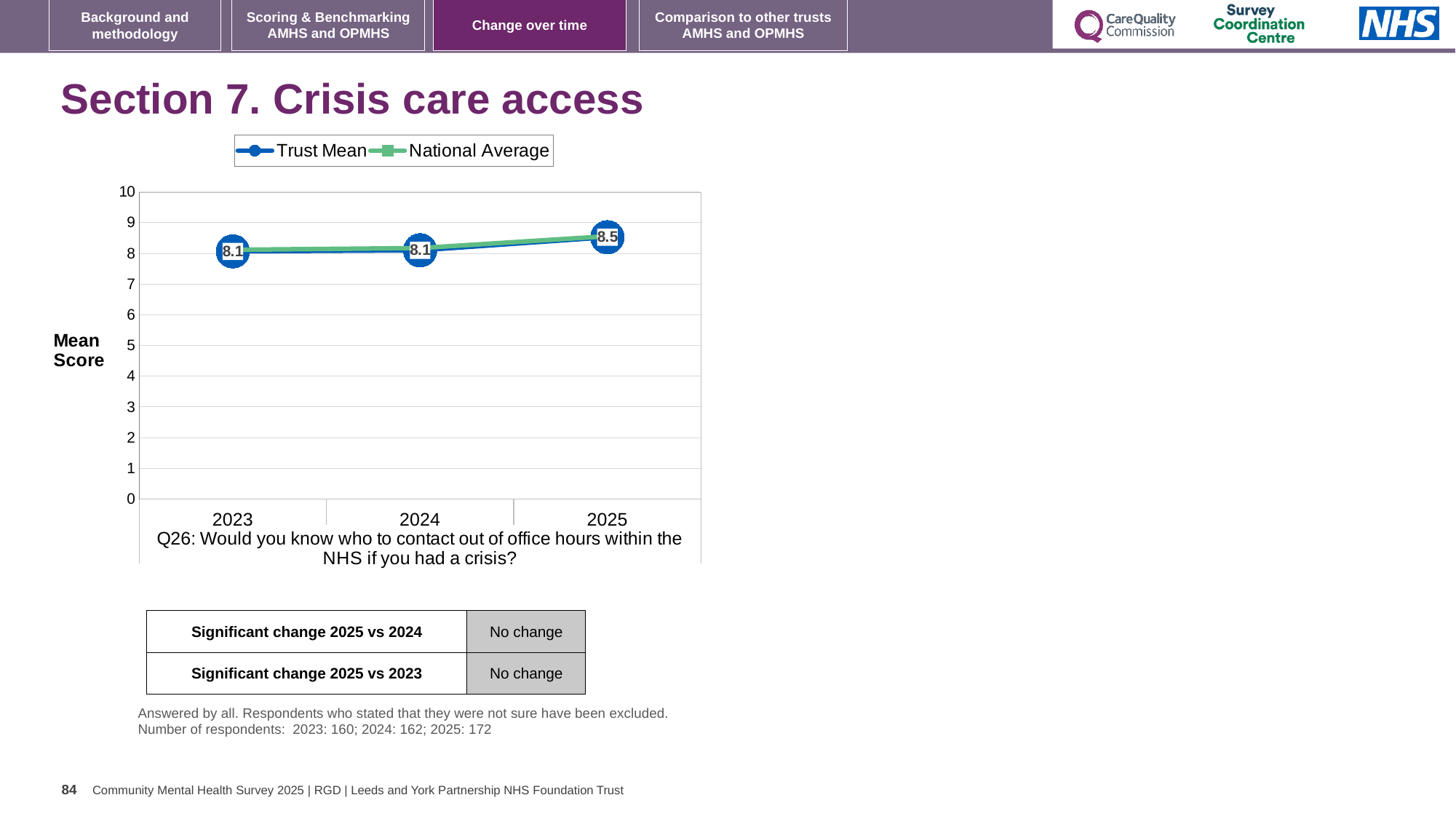
Does the Trust Mean rise or fall from 2024 to 2025? rise In which year is the Trust Mean highest? 2025 What is the Trust Mean for 2023? 8.1 What is the difference between the Trust Mean in 2025 and in 2024? 0.4 How many years are shown on the x axis? 3 How many series does the legend list? 2 What is the Trust Mean for 2025? 8.5 What is the label on the y axis of the chart? Mean Score What kind of chart is shown on the slide? line chart Is the National Average for 2025 greater or less than 8? greater Is the Trust Mean for 2025 greater or less than the Trust Mean for 2023? greater What is the Trust Mean for 2024? 8.1